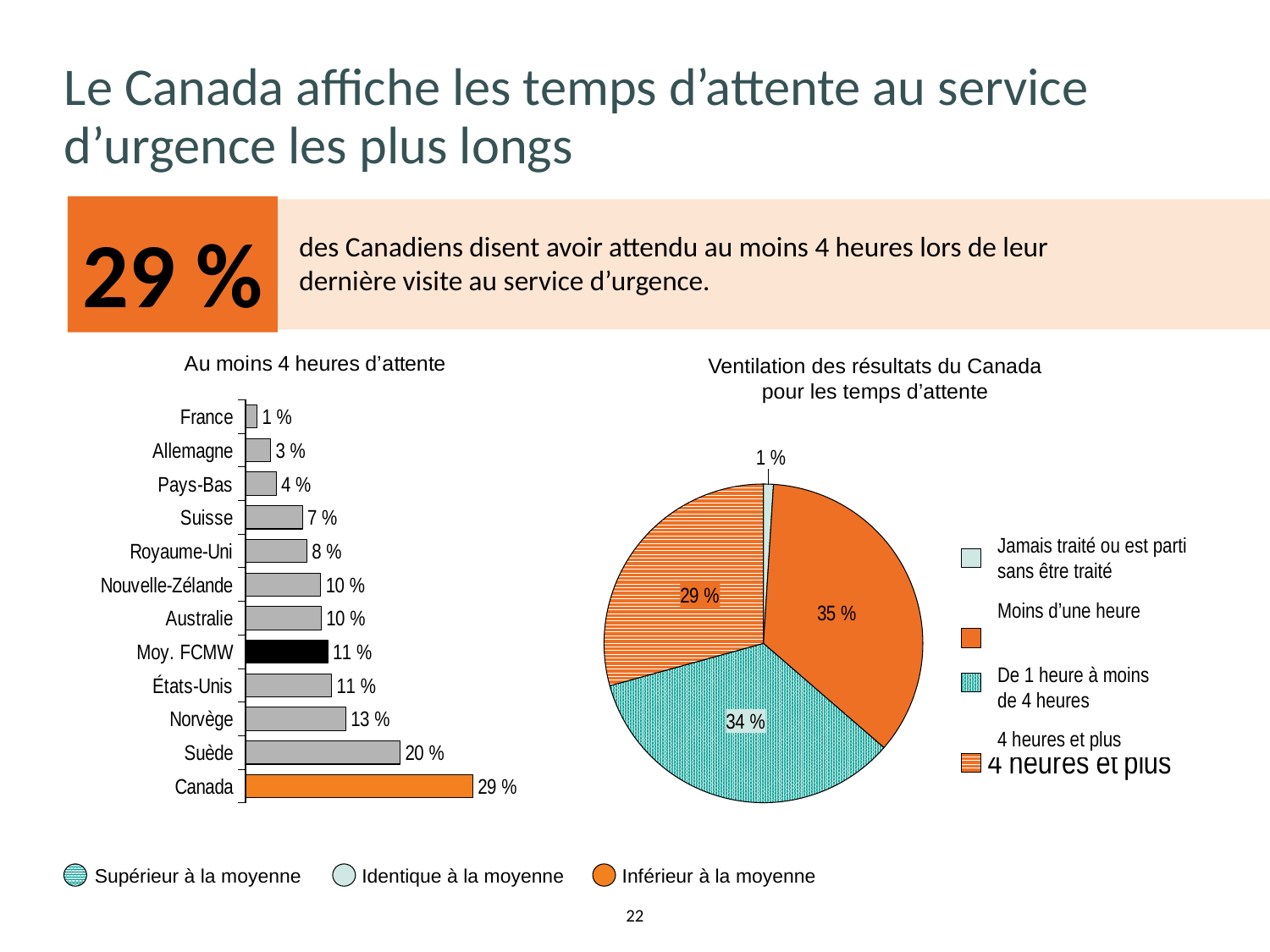
What kind of chart is 'Au moins 4 heures d'attente'? Bar chart In the bar chart 'Au moins 4 heures d'attente', what is the difference between Canada and Suède? 9 % In the bar chart 'Au moins 4 heures d'attente', which country has the highest value? Canada In the bar chart 'Au moins 4 heures d'attente', what is the value for Moy. FCMW? 11 % How many slices does the pie chart 'Ventilation des résultats du Canada pour les temps d'attente' have? 4 In the bar chart 'Au moins 4 heures d'attente', what is the value for Suède? 20 % In the pie chart 'Ventilation des résultats du Canada pour les temps d'attente', what share is 'De 1 heure à moins de 4 heures'? 34 % In the bar chart 'Au moins 4 heures d'attente', which country has the lowest value? France How many countries or categories are shown in the bar chart 'Au moins 4 heures d'attente'? 12 In the bar chart 'Au moins 4 heures d'attente', which is larger, Norvège or Suisse? Norvège In the bar chart 'Au moins 4 heures d'attente', what is the value for Canada? 29 % In the pie chart 'Ventilation des résultats du Canada pour les temps d'attente', what share is 'Moins d'une heure'? 35 %